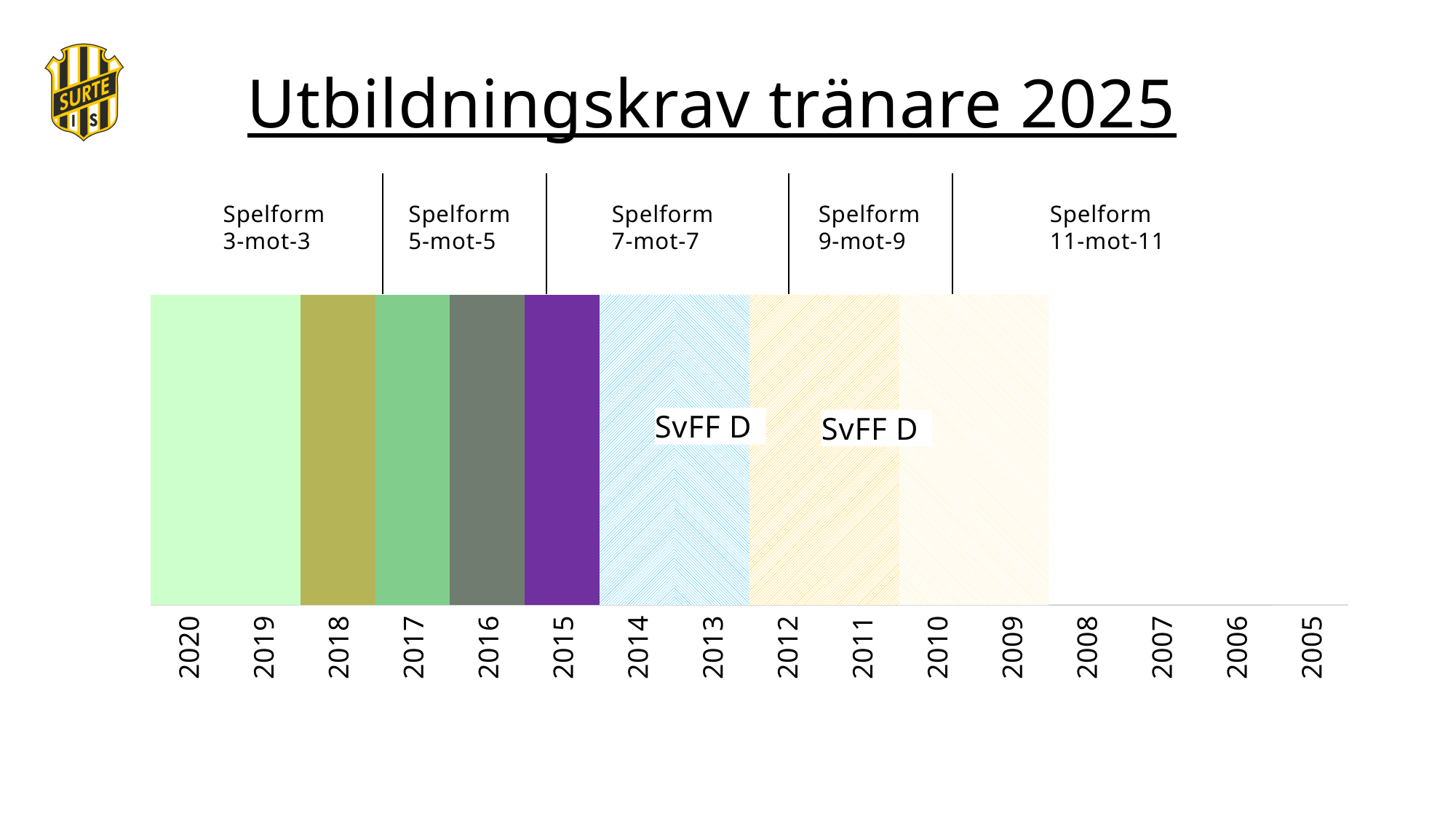
What is the title of the slide chart? Utbildningskrav tränare 2025 What text label is printed on the bars for 2014 and 2013? SvFF D What kind of chart is shown on the slide? bar chart How many 'Spelform' groups are labelled above the chart? 5 Which Spelform label sits above the bars for 2017 and 2016? Spelform 5-mot-5 Which Spelform label sits above the bars for 2020, 2019 and 2018? Spelform 3-mot-3 How many years on the x axis have no bar above them? 4 How many years on the x axis have a filled bar above them? 12 Which is the earliest year on the x axis that still has a bar? 2009 Which year is at the far right end of the x axis? 2005 Which Spelform label sits above the bars for 2012 and 2011? Spelform 9-mot-9